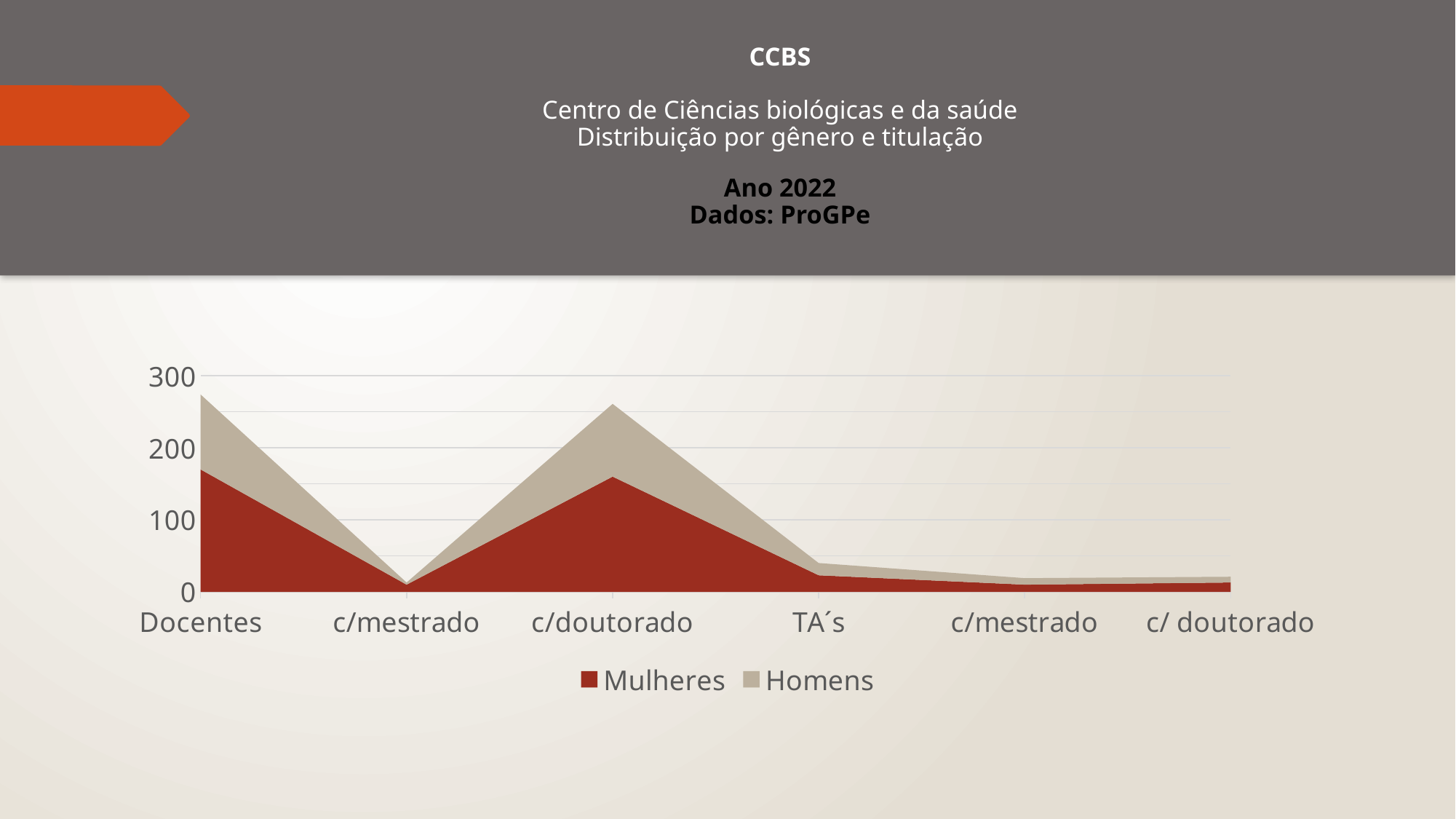
Is the value for Mulheres at c/doutorado greater or less than 100? greater Is the value for Mulheres at Docentes greater or less than 100? greater How many categories are shown along the x axis of the chart? 6 What kind of chart is shown on the slide? Area chart Which is larger for Mulheres: the value at Docentes or the value at TA´s? Docentes Which colour represents the Mulheres series in the chart? Dark red Which category has the lowest value for Mulheres? c/mestrado (both c/mestrado categories tie for the lowest value) Is the value for Mulheres at Docentes greater or less than 200? less How many series does the chart's legend list? 2 Which series are listed in the chart's legend? Mulheres and Homens